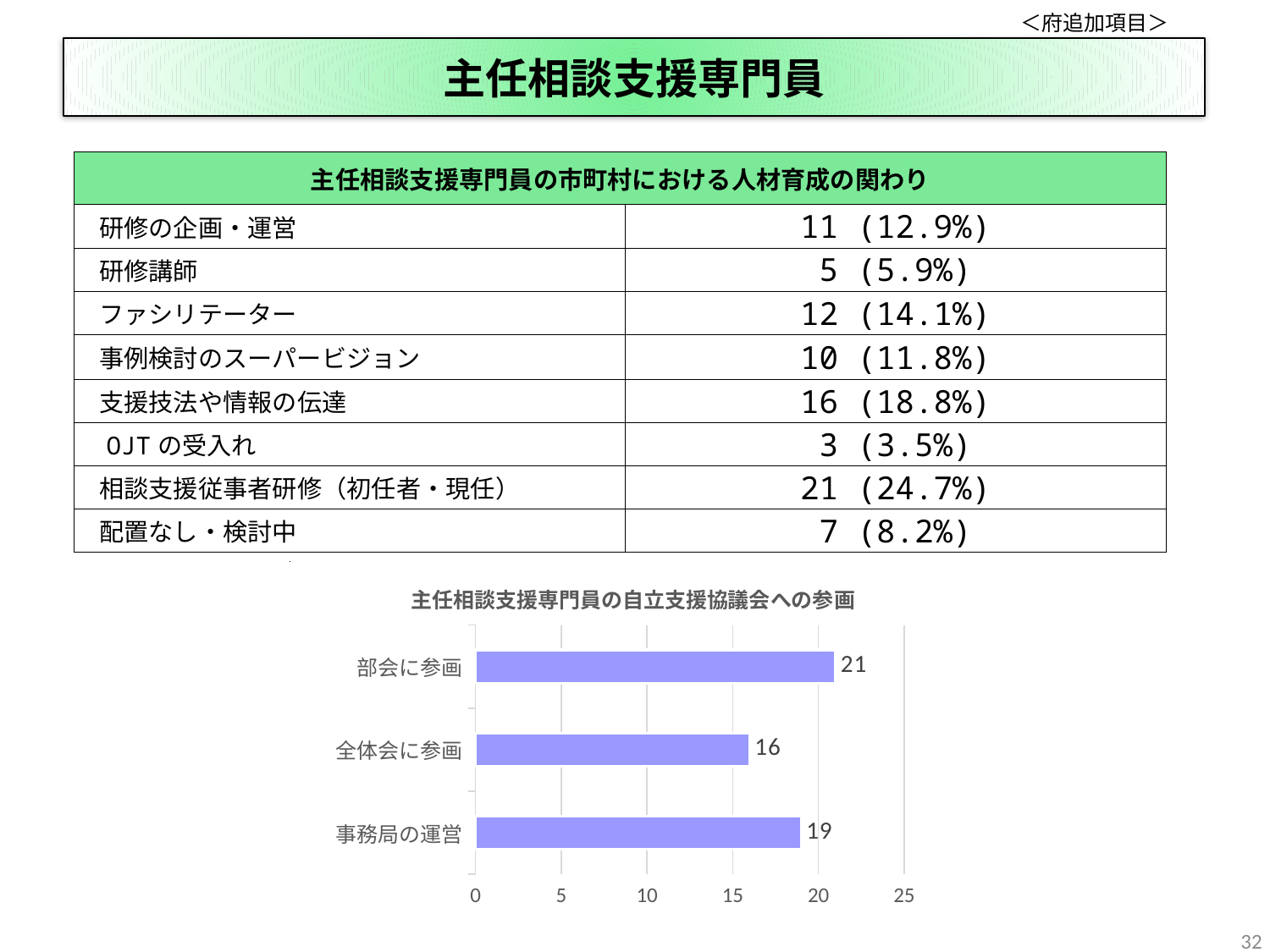
What is the title of the chart on the slide? 主任相談支援専門員の自立支援協議会への参画 Which is larger, the value for 事務局の運営 or the value for 全体会に参画? 事務局の運営 Which category has the lowest value in the chart? 全体会に参画 How many categories are shown in the chart? 3 What is the value for 部会に参画 in the chart 主任相談支援専門員の自立支援協議会への参画? 21 What kind of chart is shown on the slide? bar chart Which category has the highest value in the chart 主任相談支援専門員の自立支援協議会への参画? 部会に参画 What is the difference between the values for 事務局の運営 and 全体会に参画? 3 What is the value for 全体会に参画 in the chart? 16 What is the difference between the values for 部会に参画 and 全体会に参画? 5 What is the value for 事務局の運営 in the chart? 19 Is the value for 部会に参画 greater or less than 20? greater